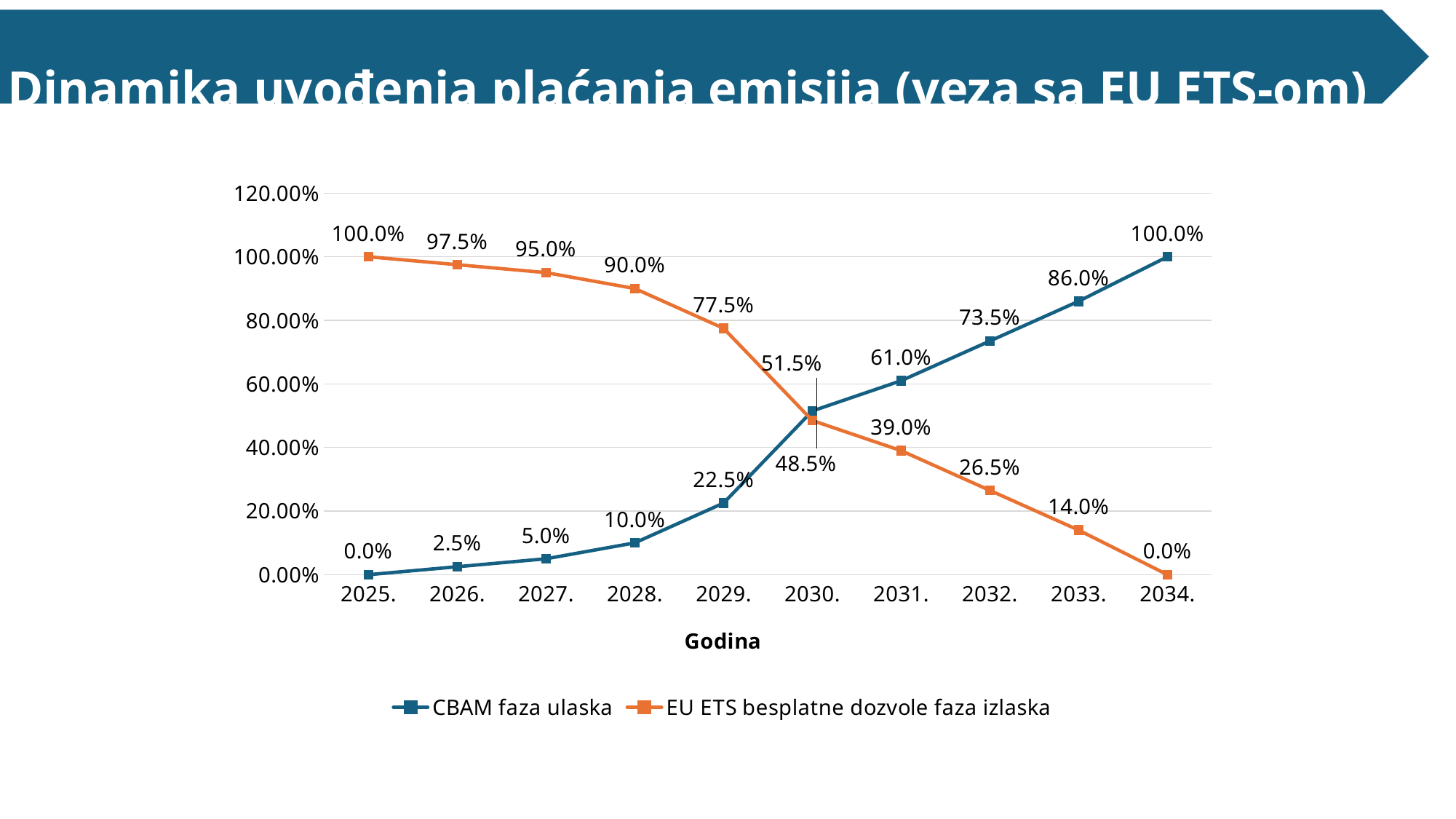
What is the label of the x axis? Godina How many years are plotted along the x axis? 10 In which year is the CBAM faza ulaska value highest? 2034. What type of chart is shown on the slide? line chart What is the value for CBAM faza ulaska in 2030.? 51.5% What is the difference between the CBAM faza ulaska values in 2033. and 2032.? 12.5% What is the value for EU ETS besplatne dozvole faza izlaska in 2031.? 39.0% Do the values for EU ETS besplatne dozvole faza izlaska rise or fall from 2025. to 2034.? fall What is the value for CBAM faza ulaska in 2029.? 22.5% Which series has the larger value in 2028., CBAM faza ulaska or EU ETS besplatne dozvole faza izlaska? EU ETS besplatne dozvole faza izlaska In which year is the EU ETS besplatne dozvole faza izlaska value lowest? 2034. How many series does the legend list? 2